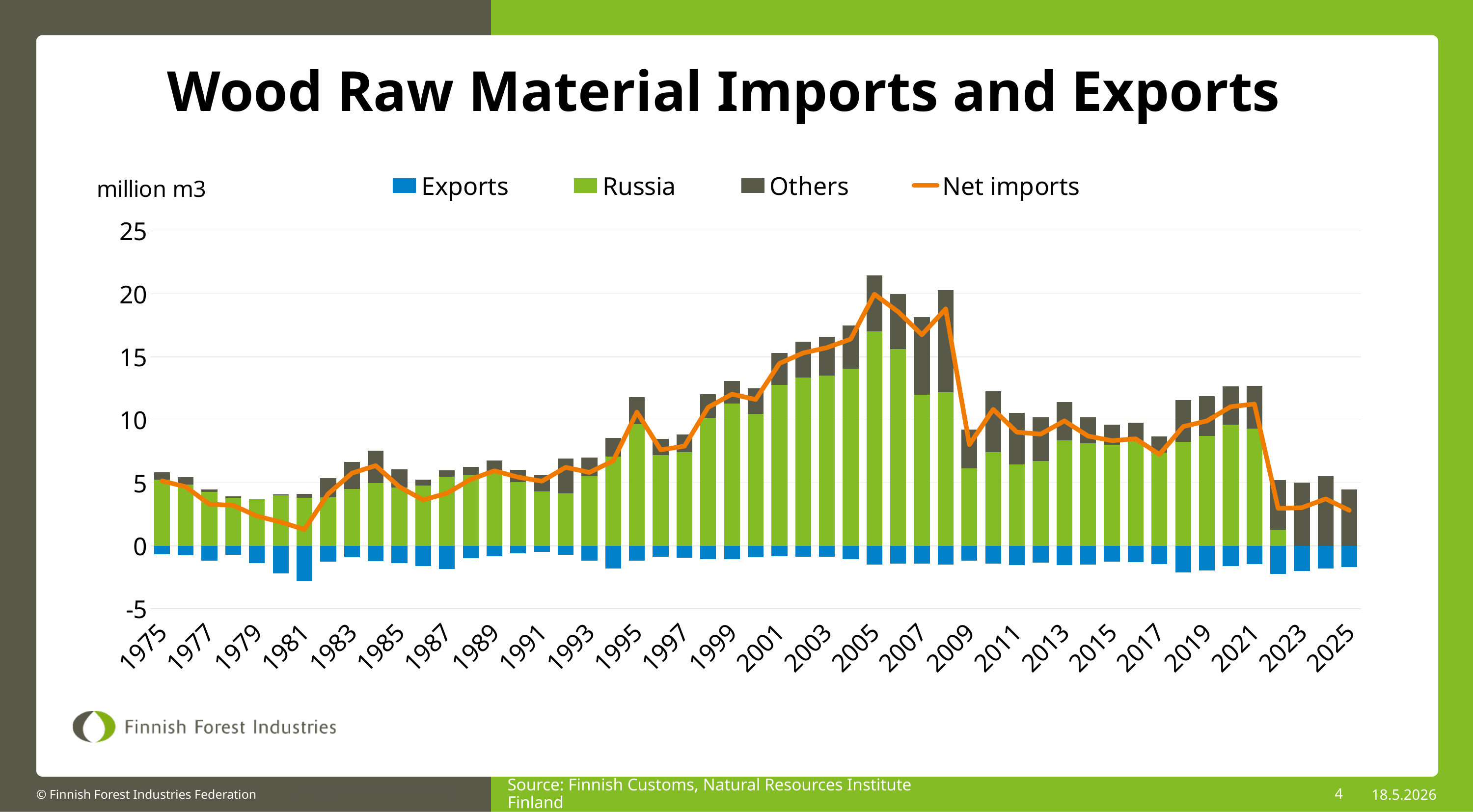
What kind of chart is shown on the slide? Stacked bar chart with a line In which year is the Net imports line at its lowest? 1981 In which year is the total imports bar (Russia plus Others) the tallest? 2005 How many series does the legend list? 4 Does the Net imports line rise or fall between 2005 and 2009? fall Is the Net imports value for 2025 greater or less than 5? less Which series is drawn as an orange line rather than bars? Net imports Is the Russia value for 2005 greater or less than 15? greater In which year does the Net imports line reach its highest value? 2005 Is the Net imports value for 2005 greater or less than 15? greater What unit is shown for the y axis? million m3 Which year has the larger Russia value, 2005 or 2021? 2005